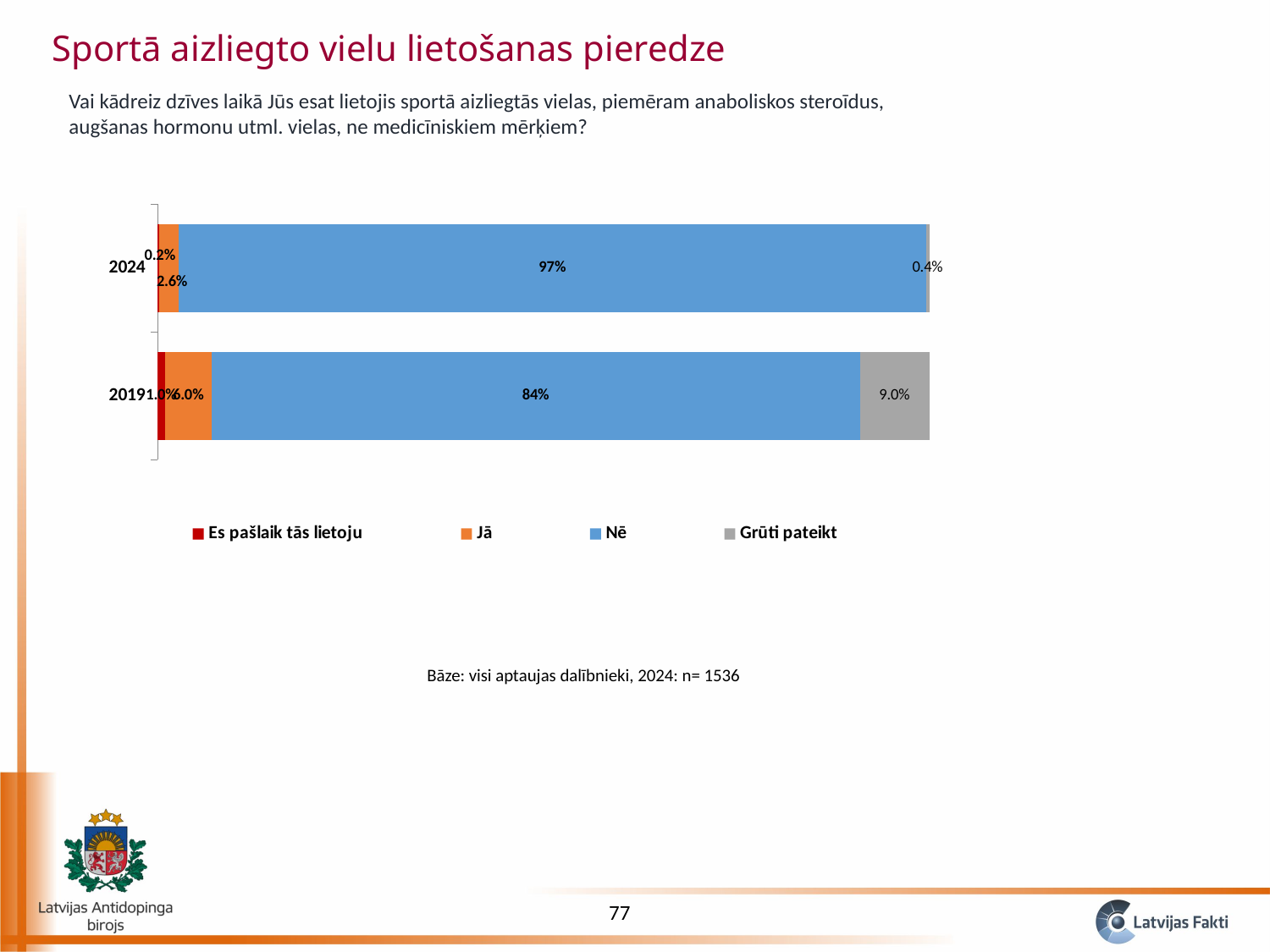
Which year has the larger "Grūti pateikt" share, 2019 or 2024? 2019 What is the value for "Grūti pateikt" in 2024? 0.4% What type of chart is shown on the slide? Stacked bar chart What is the value for "Grūti pateikt" in 2019? 9.0% By how many percentage points did the "Nē" share change from 2019 to 2024? 13 percentage points Which colour represents "Nē" in the chart? Blue How many series does the legend list? 4 What is the value for "Es pašlaik tās lietoju" in 2024? 0.2% What is the value for "Jā" in 2024? 2.6% How many years (bars) are shown in the chart? 2 What percentage of respondents answered "Nē" in 2024? 97% What percentage of respondents answered "Nē" in 2019? 84%